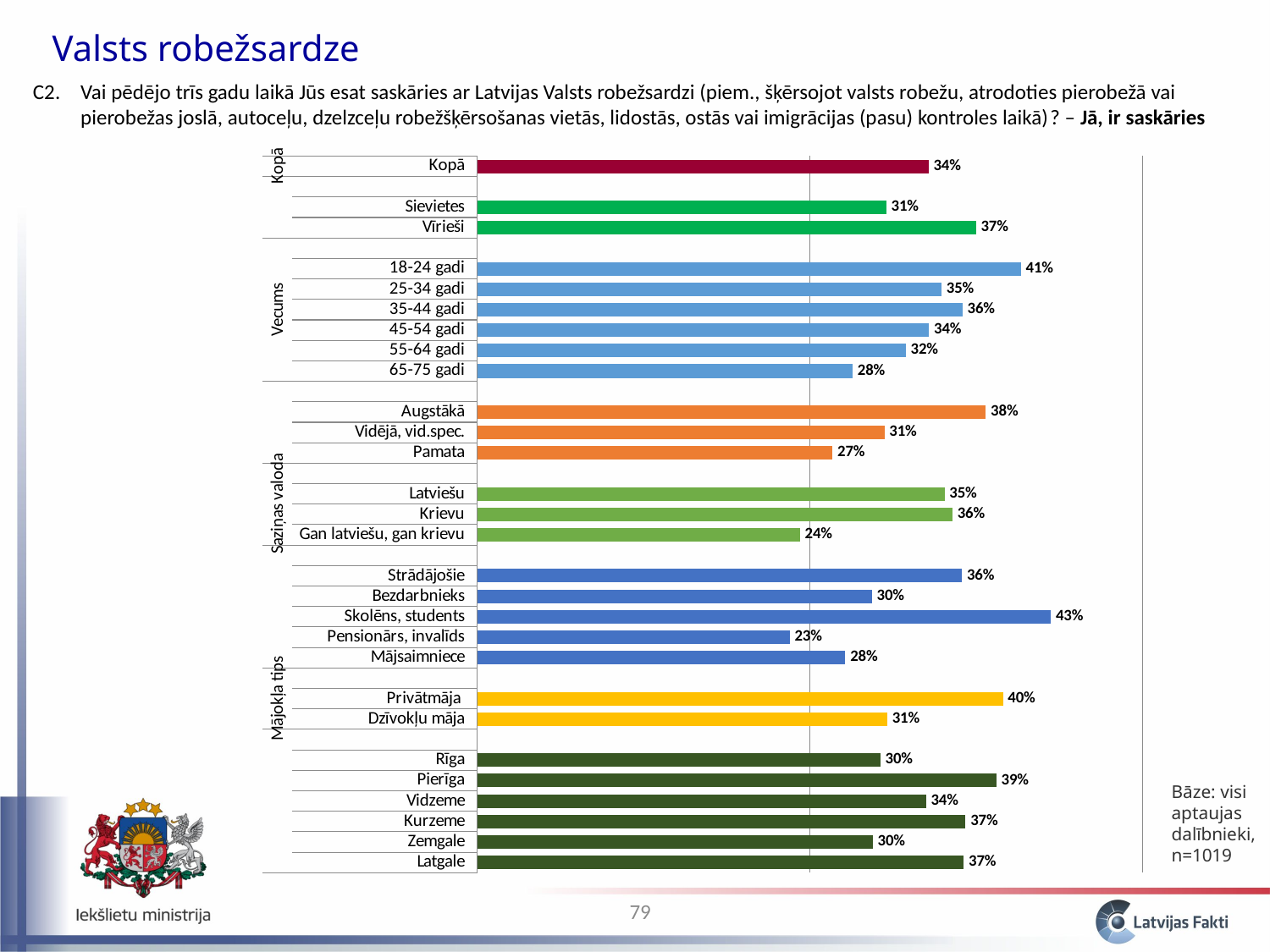
What is the value for Gan latviešu, gan krievu? 24% Which category has the highest value on the chart? Skolēns, students What is the value for Kopā? 34% Which category has the lowest value on the chart? Pensionārs, invalīds Which is larger, the value for Pierīga or the value for Rīga? Pierīga What kind of chart is shown on the slide? Bar chart What is the value for 18-24 gadi? 41% How many bars are plotted on the chart? 28 What is the value for Privātmāja? 40% Which is larger, the value for 65-75 gadi or the value for 25-34 gadi? 25-34 gadi What is the difference between the values for Vīrieši and Sievietes? 6% What is the difference between the values for Augstākā and Pamata? 11%